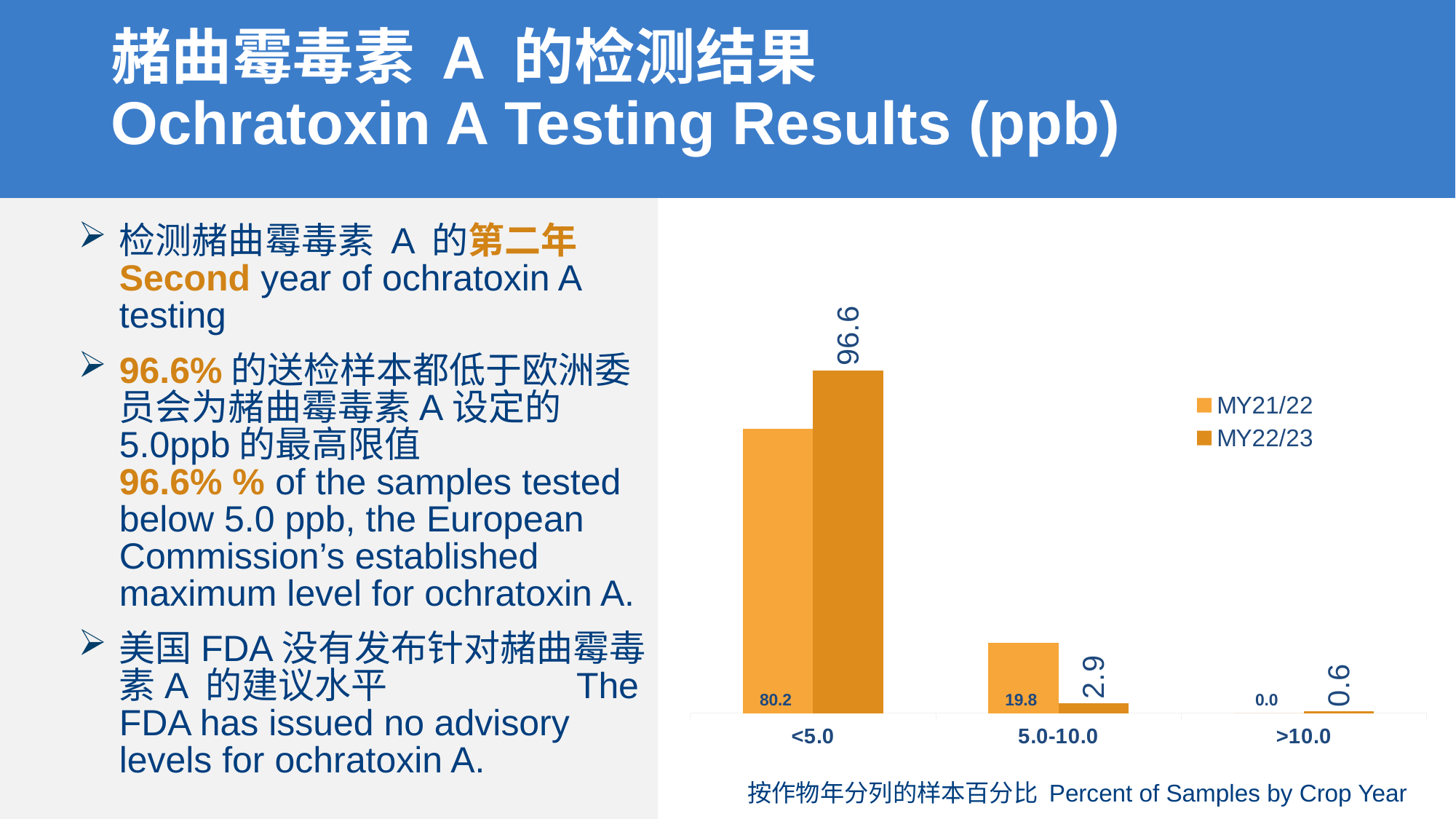
What is the value for MY21/22 in the <5.0 category? 80.2 What is the value for MY21/22 in the 5.0-10.0 category? 19.8 What is the value for MY22/23 in the 5.0-10.0 category? 2.9 How many series does the legend list? 2 What kind of chart is shown on the slide? Bar chart What is the value for MY22/23 in the <5.0 category? 96.6 What is the difference between the MY22/23 and MY21/22 values in the <5.0 category? 16.4 Which category has the highest value for MY22/23? <5.0 In the 5.0-10.0 category, which series has the larger value, MY21/22 or MY22/23? MY21/22 Which category has the lowest value for MY21/22? >10.0 What is the value for MY22/23 in the >10.0 category? 0.6 What is the value for MY21/22 in the >10.0 category? 0.0